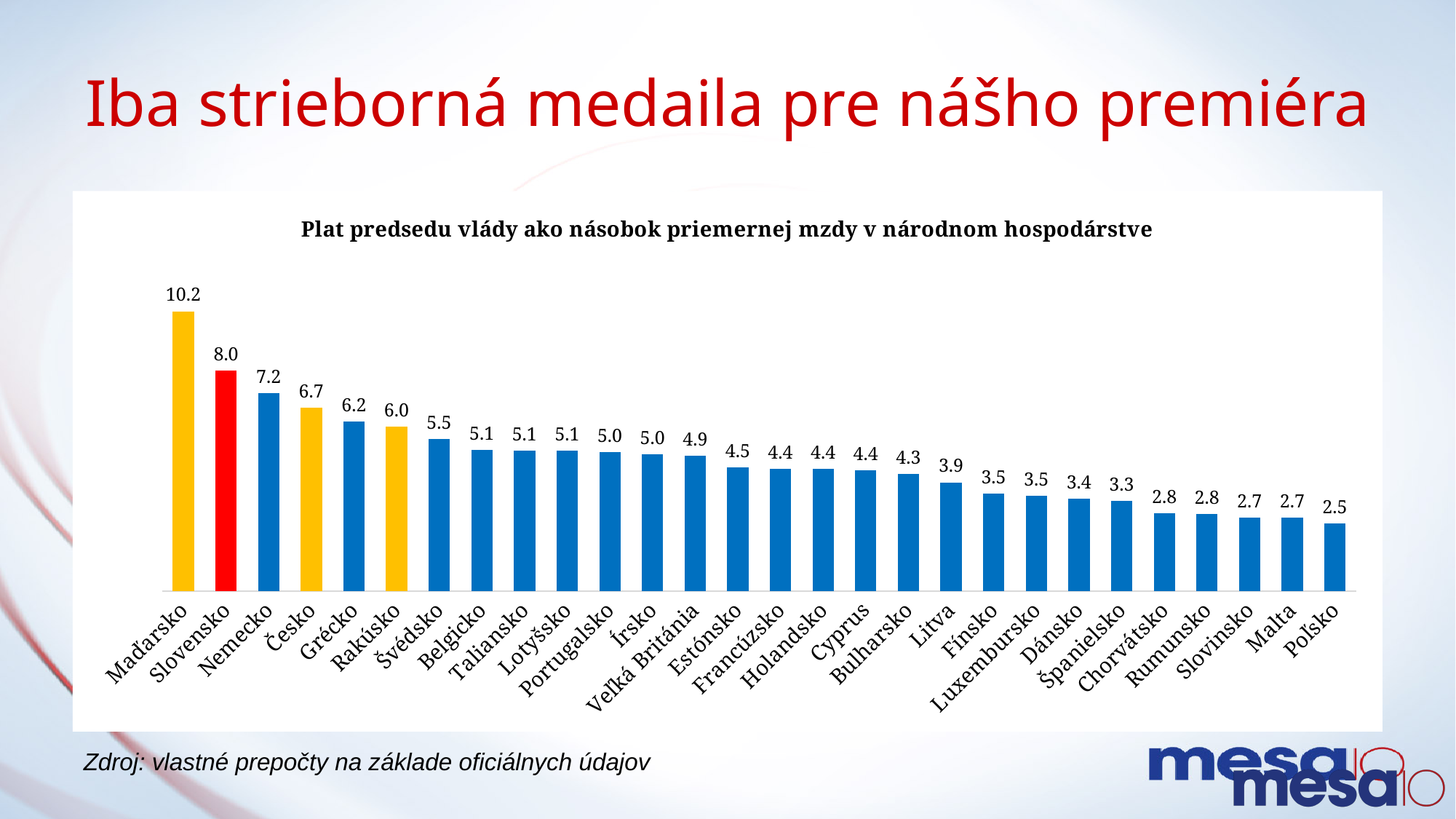
Which country has the lowest value? Poľsko What is the value for Slovensko? 8.0 Which is larger, the value for Česko or the value for Rakúsko? Česko What kind of chart is shown on the slide? Bar chart What is the value for Nemecko? 7.2 Do the values rise or fall from left to right along the x axis? Fall What colour is the bar for Slovensko? Red How many countries are shown in the chart? 28 What is the difference between the values for Maďarsko and Slovensko? 2.2 What is the value for Veľká Británia? 4.9 Which country has the highest value? Maďarsko What is the value for Poľsko? 2.5